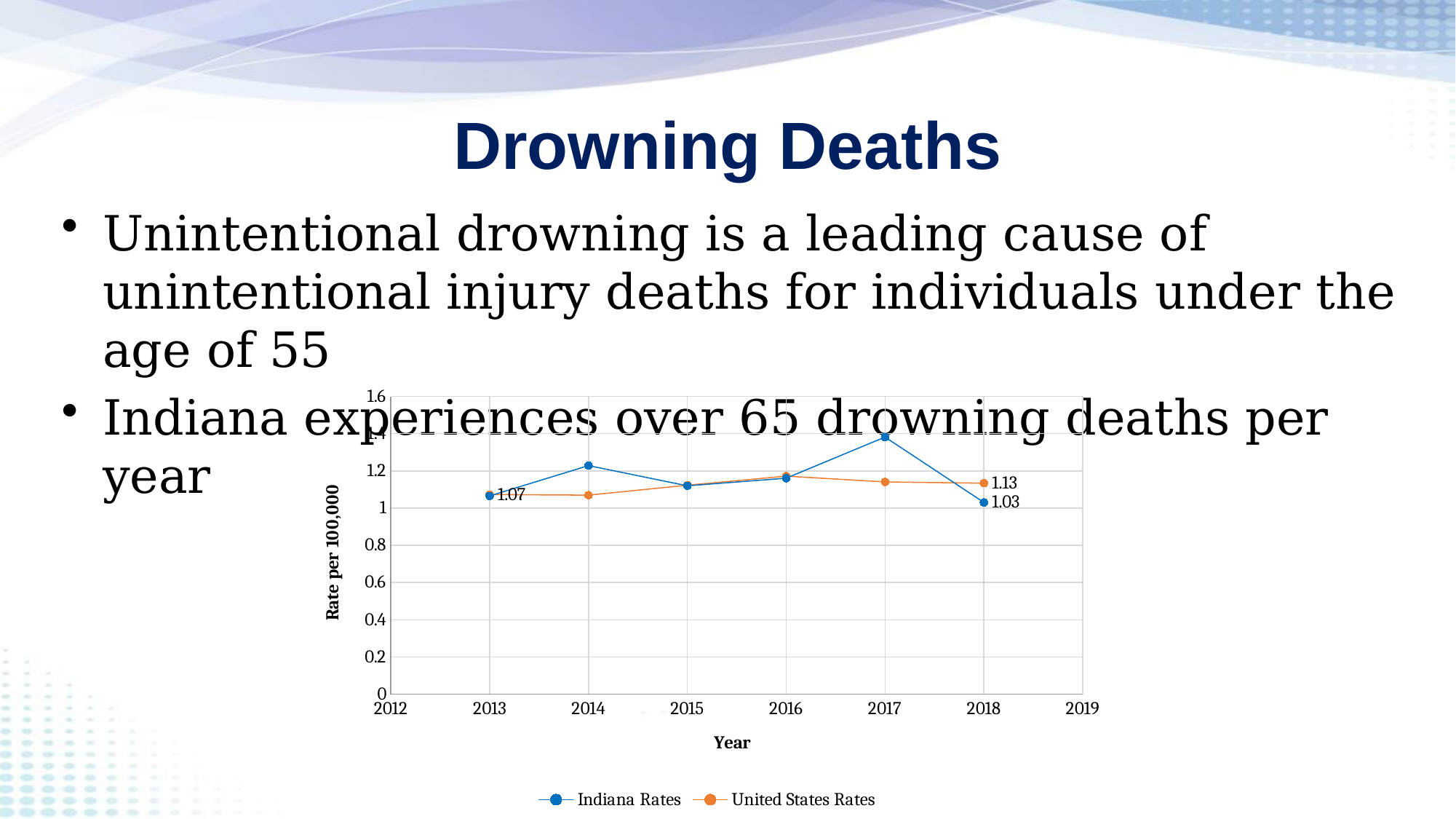
How many years have data points plotted on the chart? 6 What is the Indiana rate in 2013? 1.07 What is the difference between the United States rate and the Indiana rate in 2018? 0.10 What kind of chart is shown on the slide? Line chart Is the Indiana rate in 2017 greater or less than 1.2? greater Is the United States rate in 2014 greater or less than 1.2? less What is the United States rate in 2018? 1.13 In which year is the Indiana rate lowest? 2018 What is the Indiana rate in 2018? 1.03 In which year is the Indiana rate highest? 2017 In 2017, which is larger: the Indiana rate or the United States rate? Indiana Rates How many series does the legend list? 2